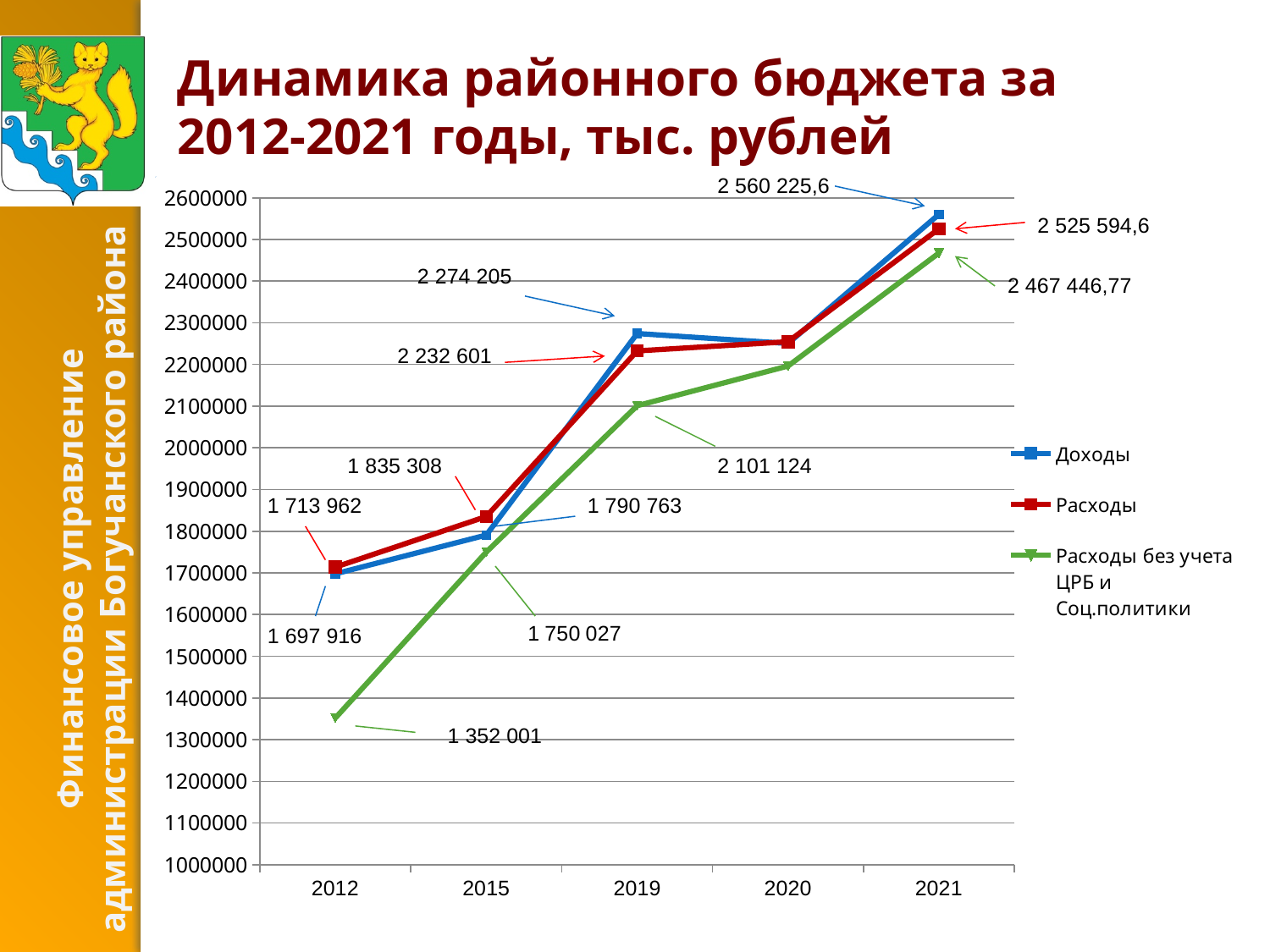
Is the value of Расходы без учета ЦРБ и Соц.политики in 2020 greater or less than 2100000? greater What is the difference between Доходы and Расходы in 2021? 34 631 How many series does the legend list? 3 In which year is Доходы highest? 2021 In which year is Расходы без учета ЦРБ и Соц.политики lowest? 2012 What is the value of Расходы in 2015? 1 835 308 What kind of chart is shown on the slide? line chart How many years are shown on the x axis? 5 What is the value of Доходы in 2021? 2 560 225,6 What is the value of Расходы без учета ЦРБ и Соц.политики in 2019? 2 101 124 Which is larger in 2019, Доходы or Расходы? Доходы What is the value of Доходы in 2012? 1 697 916